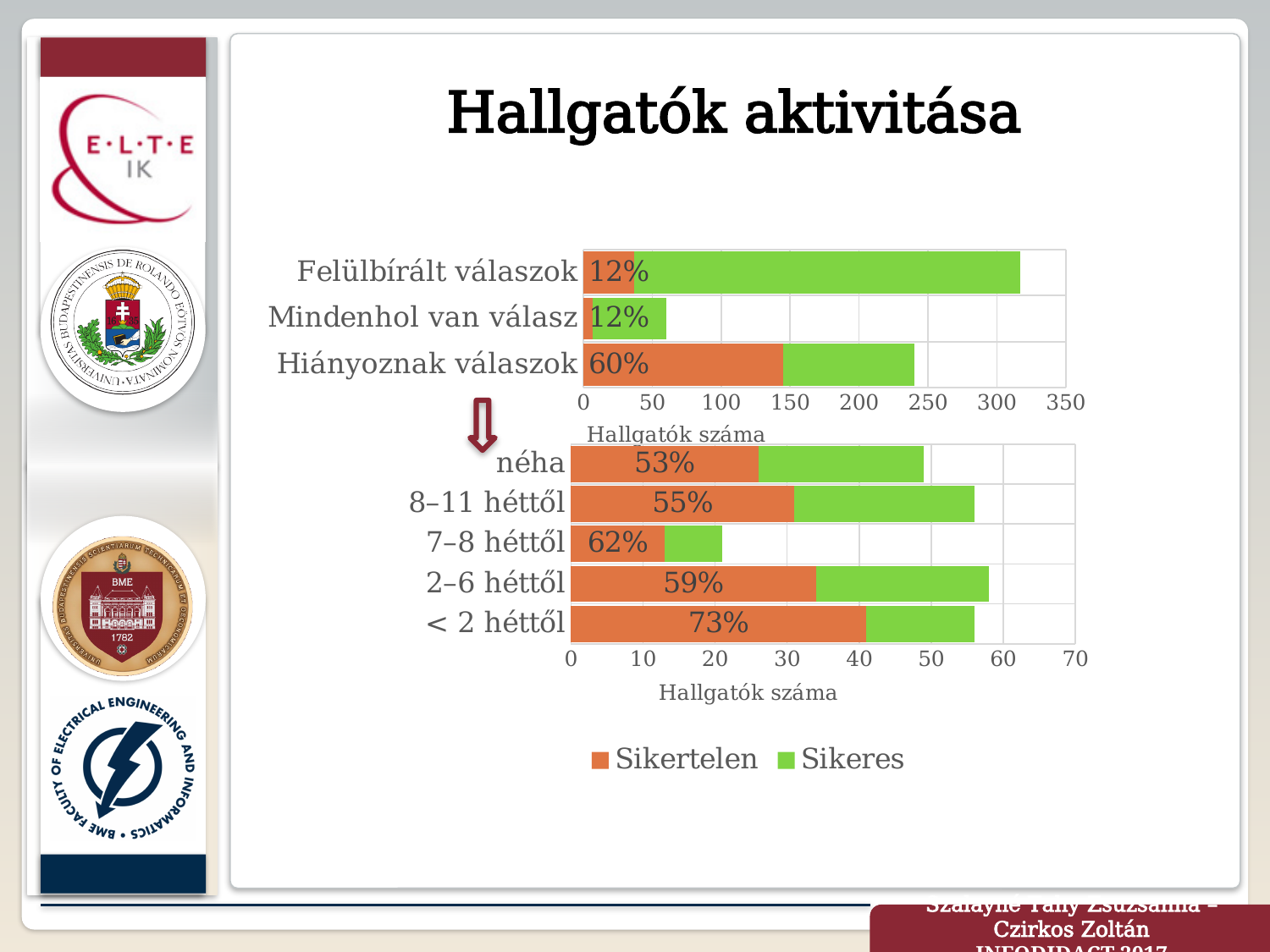
In the bottom chart, what percentage label is shown for 7–8 héttől? 62% In the bottom chart, which category has the highest percentage label? < 2 héttől How many series does the legend list? 2 In the top chart, what percentage label is shown for Hiányoznak válaszok? 60% In the bottom chart, what percentage label is shown for < 2 héttől? 73% In the top chart, what percentage label is shown for Felülbírált válaszok? 12% In the bottom chart, which category has the lowest percentage label? néha In the bottom chart, which category has the shortest total bar? 7–8 héttől In the top chart, is the total bar for Felülbírált válaszok greater or less than 300? greater In the bottom chart, is the total bar for 7–8 héttől greater or less than 30? less How many categories does the bottom chart show? 5 In the top chart, which category has the longest total bar? Felülbírált válaszok